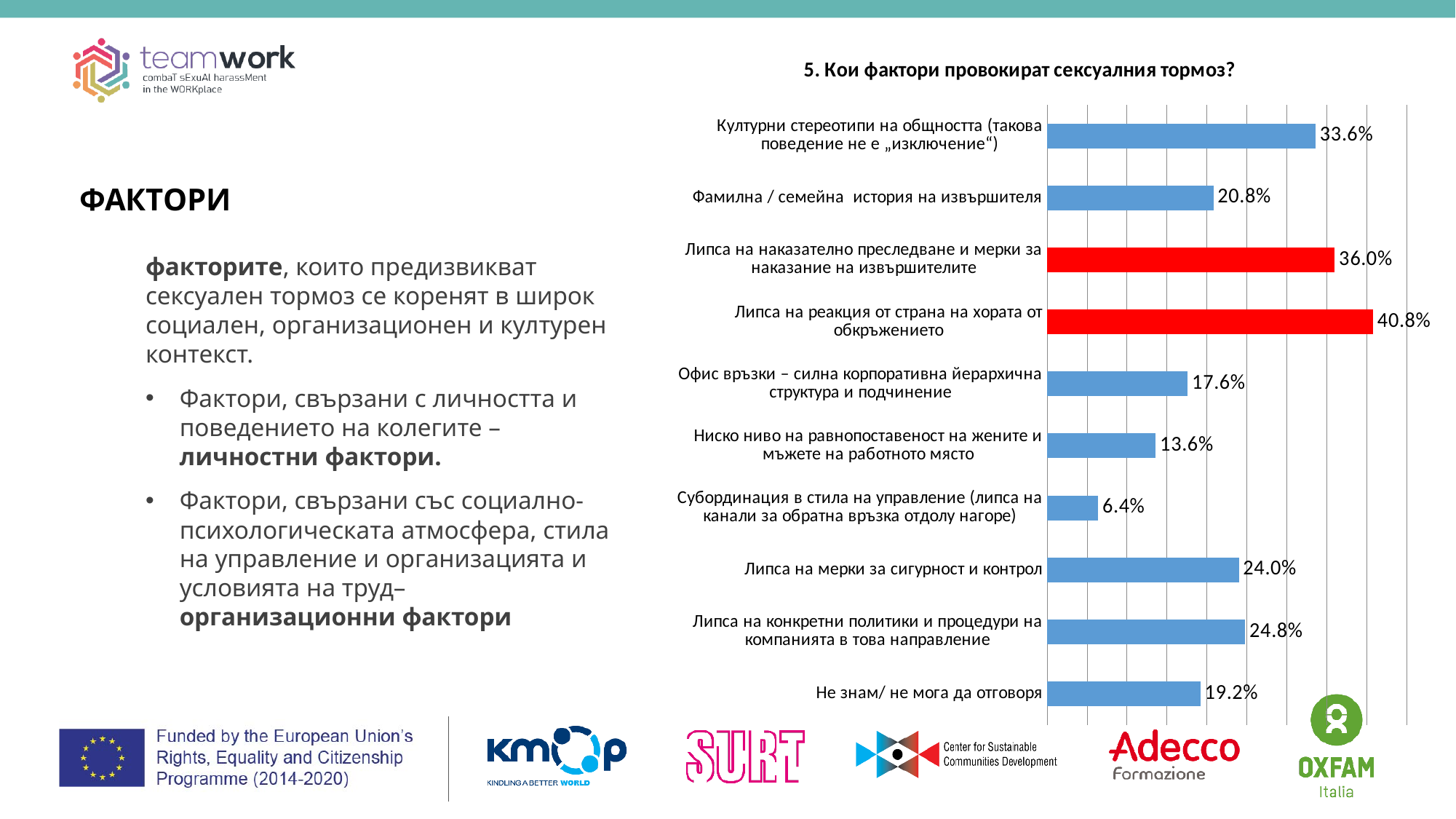
What is the value for "Фамилна / семейна история на извършителя"? 20.8% Which category has the lowest value? Субординация в стила на управление (липса на канали за обратна връзка отдолу нагоре) What is the difference between the values for "Офис връзки – силна корпоративна йерархична структура и подчинение" and "Ниско ниво на равнопоставеност на жените и мъжете на работното място"? 4.0% What is the value for "Не знам/ не мога да отговоря"? 19.2% What is the value for "Липса на реакция от страна на хората от обкръжението"? 40.8% How many categories does the chart show? 10 What is the title of the chart? 5. Кои фактори провокират сексуалния тормоз? What type of chart is shown on the slide? bar chart How many bars in the chart are coloured red? 2 Which category has the highest value? Липса на реакция от страна на хората от обкръжението What is the difference between the values for "Липса на наказателно преследване и мерки за наказание на извършителите" and "Културни стереотипи на общността"? 2.4% Which is larger: the value for "Липса на мерки за сигурност и контрол" or the value for "Липса на конкретни политики и процедури на компанията в това направление"? Липса на конкретни политики и процедури на компанията в това направление